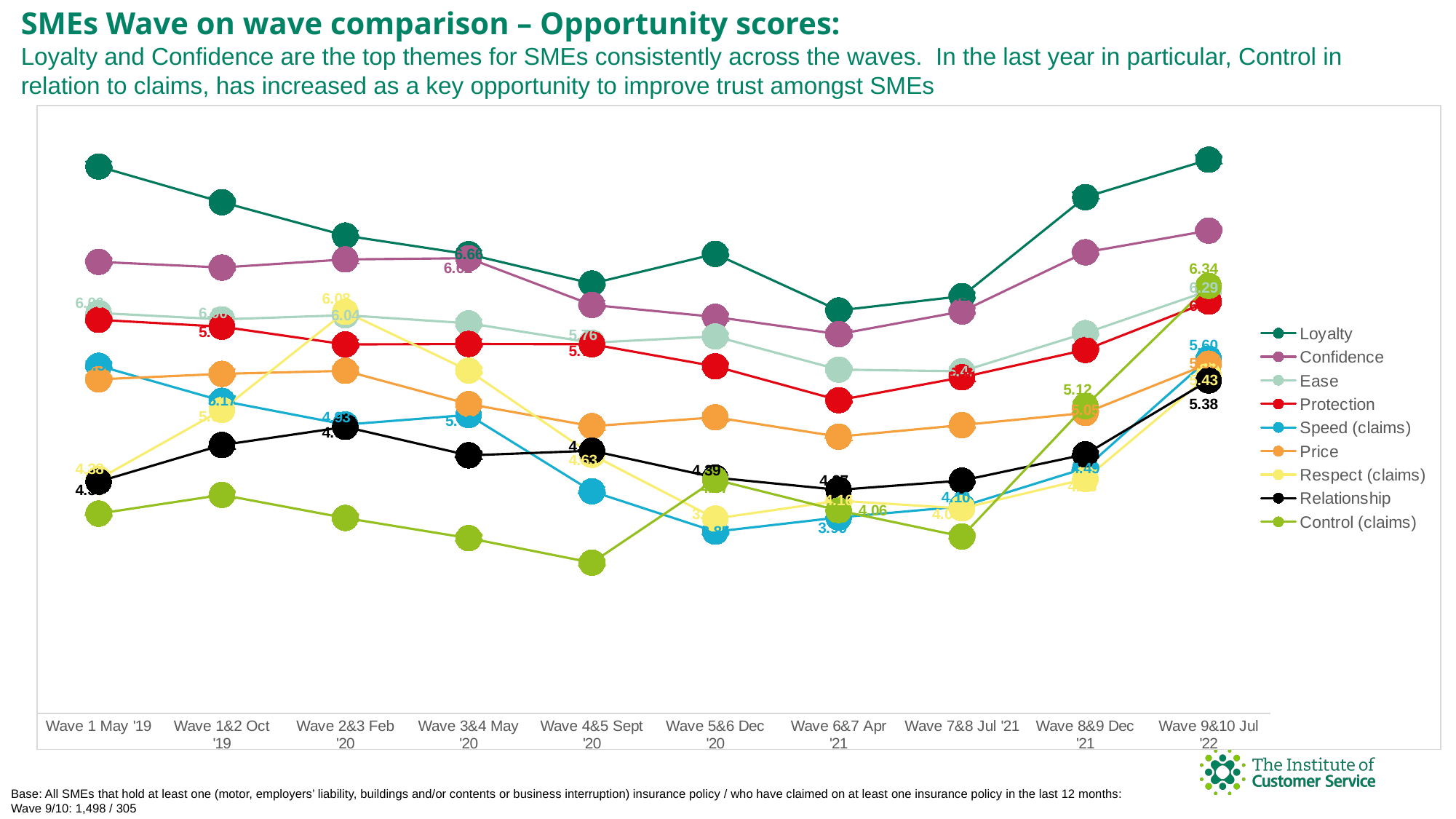
Which theme has the lowest score at Wave 4&5 Sept '20? Control (claims) Which theme has the highest score at Wave 1 May '19? Loyalty What is the Speed (claims) score at Wave 9&10 Jul '22? 5.60 How many series does the legend list? 9 At Wave 1 May '19, which is higher: Loyalty or Confidence? Loyalty By how much did the Control (claims) score increase from Wave 8&9 Dec '21 to Wave 9&10 Jul '22? 1.22 What kind of chart is shown on the slide? line chart How many waves are shown along the x axis? 10 What is the Control (claims) score at Wave 8&9 Dec '21? 5.12 Does the Loyalty score rise or fall from Wave 1 May '19 to Wave 6&7 Apr '21? fall What is the Loyalty score at Wave 3&4 May '20? 6.66 What is the Control (claims) score at Wave 9&10 Jul '22? 6.34